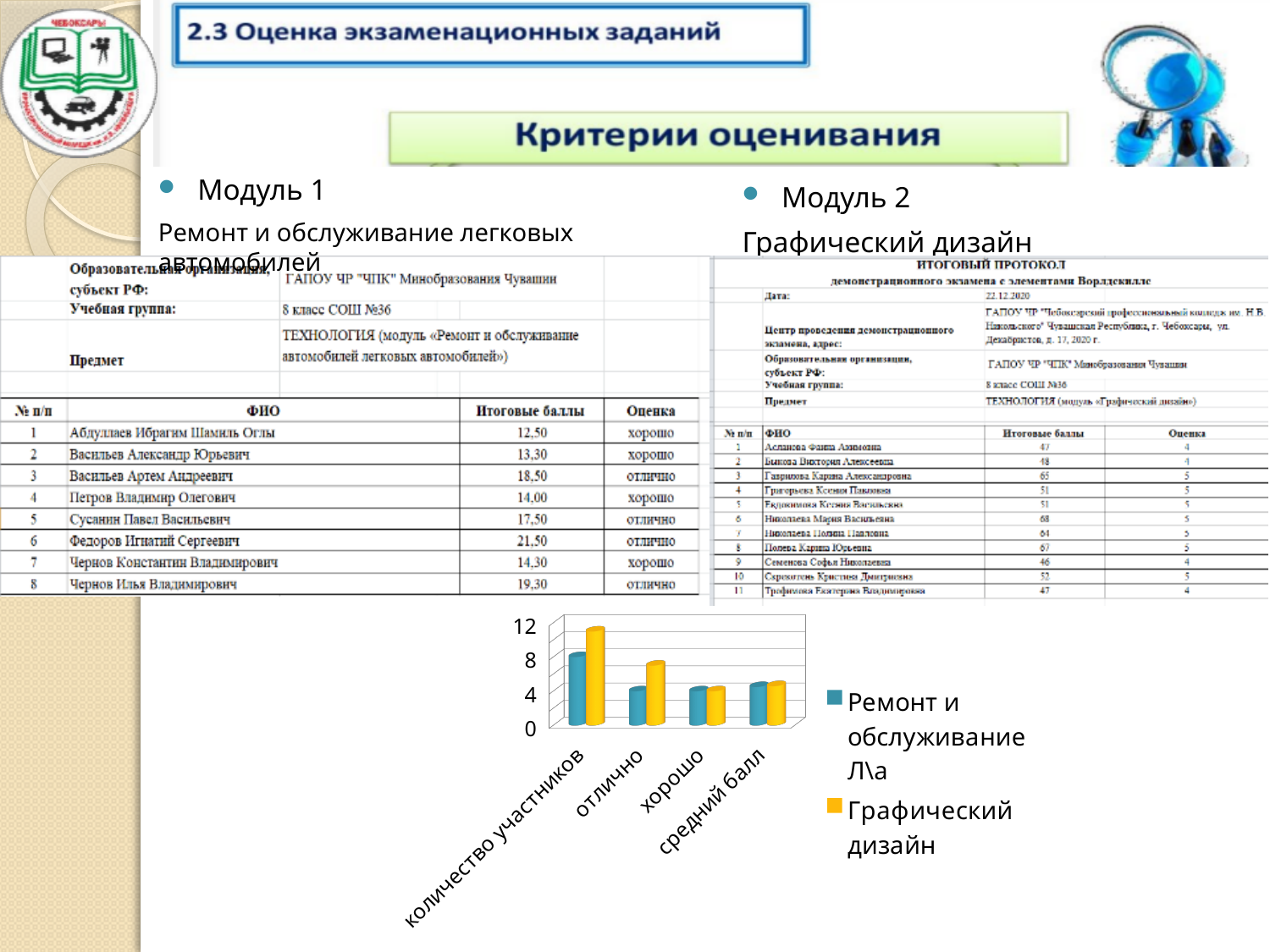
How many categories are shown on the x axis of the chart? 4 For the category количество участников, which series has the larger value? Графический дизайн Is the value for отлично in the Ремонт и обслуживание Л\а series greater or less than 8? less Is the value for количество участников in the Ремонт и обслуживание Л\а series greater or less than 4? greater For the category отлично, which series has the larger value? Графический дизайн Which two series are listed in the chart legend? Ремонт и обслуживание Л\а and Графический дизайн Is the value for отлично in the Графический дизайн series greater or less than 4? greater How many series does the chart legend list? 2 Which colour represents the series Графический дизайн in the chart? yellow In the Графический дизайн series, which category has the highest value? количество участников What kind of chart is shown on the slide? bar chart